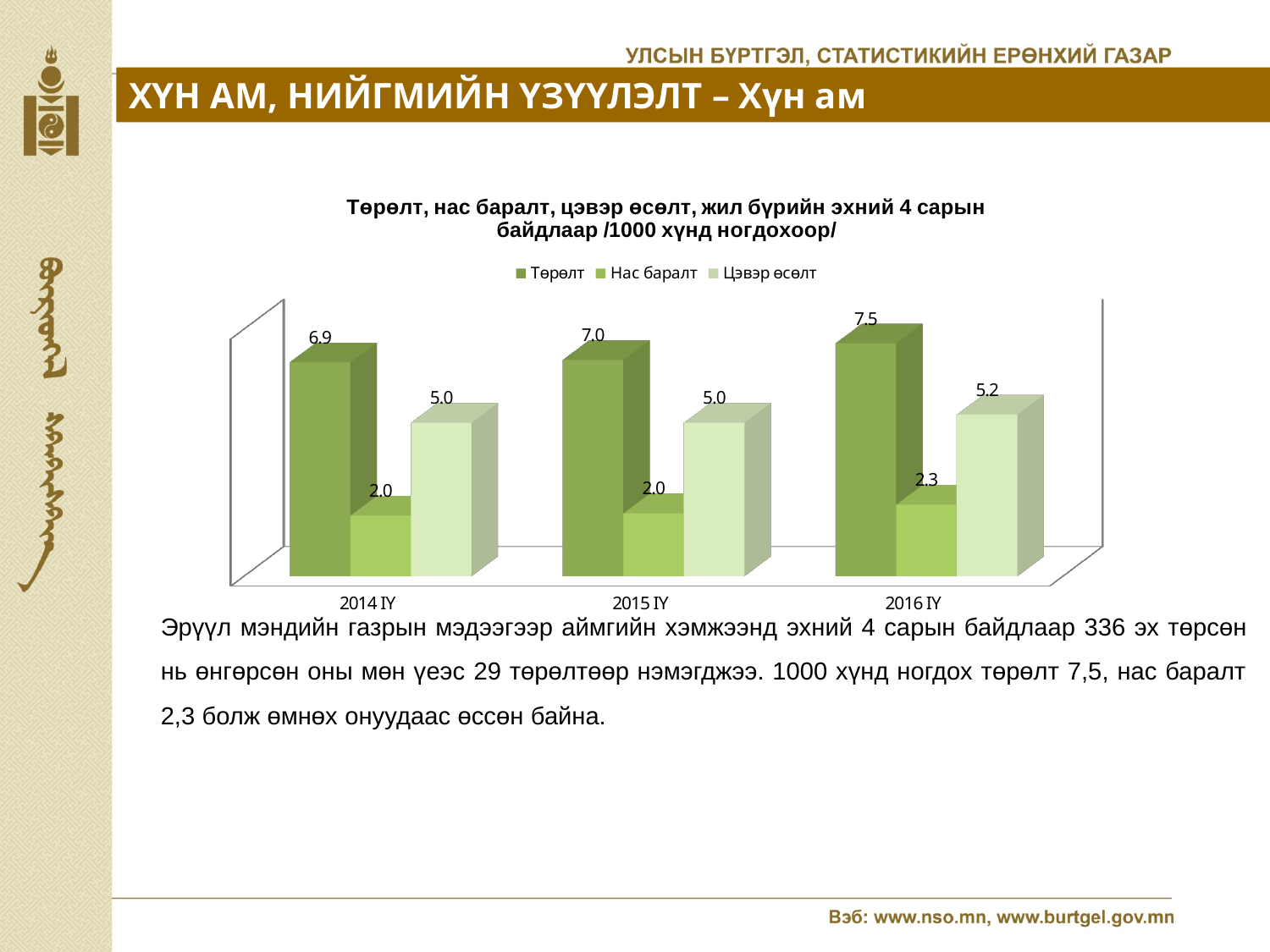
What is the value of Цэвэр өсөлт for 2016 IY? 5.2 How many years are shown on the x axis? 3 In which year is Төрөлт highest? 2016 IY Does Төрөлт rise or fall from 2014 IY to 2016 IY? Rise What is the value of Төрөлт for 2015 IY? 7.0 What is the difference between Төрөлт and Нас баралт in 2016 IY? 5.2 Which is larger in 2014 IY: Төрөлт or Цэвэр өсөлт? Төрөлт How many series does the legend list? 3 What is the value of Нас баралт for 2014 IY? 2.0 What kind of chart is shown? Bar chart In which year is Төрөлт lowest? 2014 IY What is the value of Төрөлт for 2016 IY? 7.5